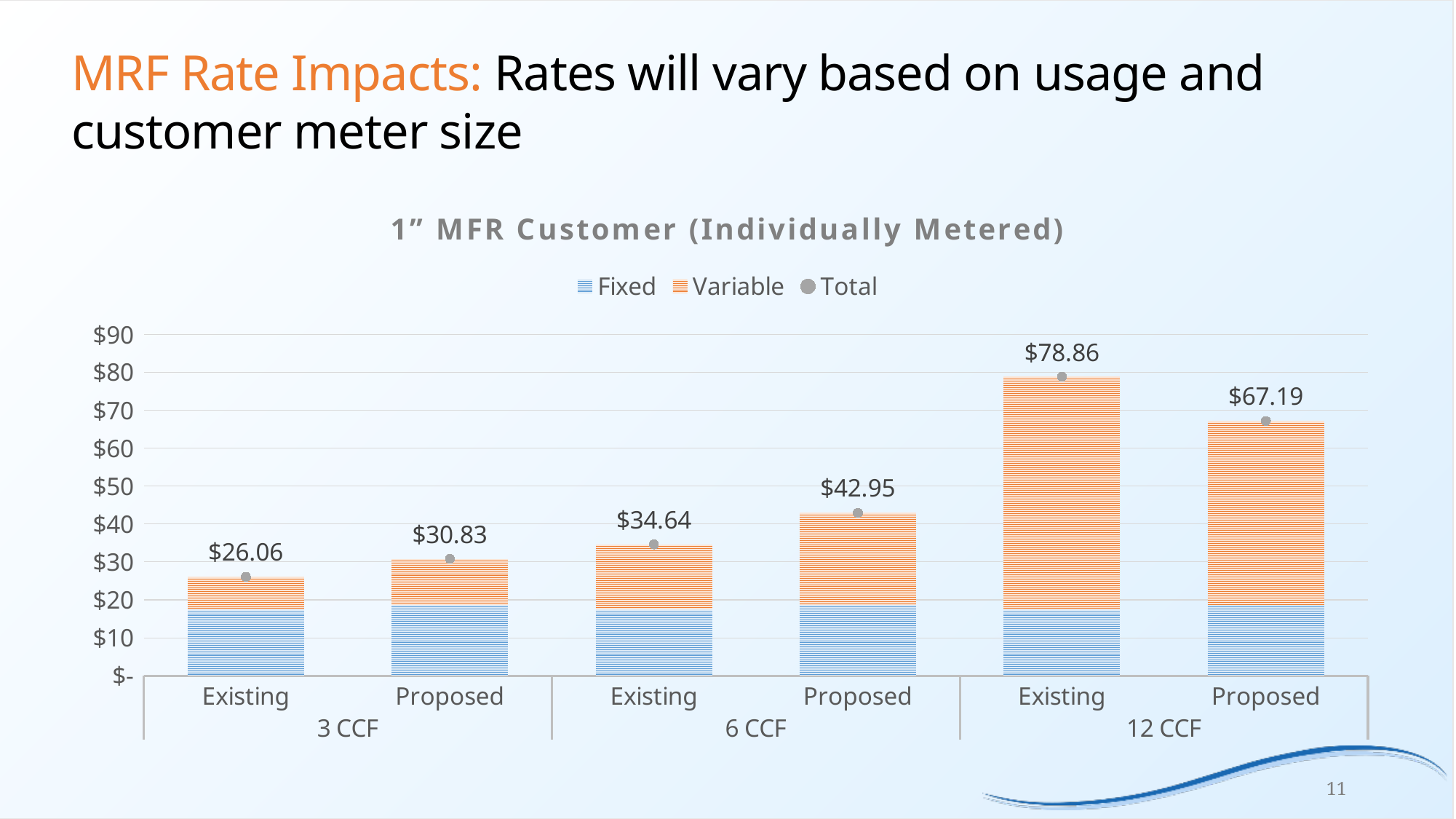
What is the Total for the Proposed rate at 6 CCF? $42.95 What is the difference between the Existing and Proposed Totals at 12 CCF? $11.67 Which is larger, the Existing Total at 6 CCF or the Proposed Total at 6 CCF? Proposed Total at 6 CCF How many series does the legend list? 3 Which bar has the highest Total value? Existing, 12 CCF What is the Total for the Proposed rate at 12 CCF? $67.19 What is the difference between the Proposed and Existing Totals at 3 CCF? $4.77 Which bar has the lowest Total value? Existing, 3 CCF How many bars are plotted in the chart? 6 Is the Fixed portion of the Existing bar at 3 CCF greater or less than $20? less What type of chart is shown on the slide? Stacked bar chart What is the Total for the Existing rate at 3 CCF? $26.06